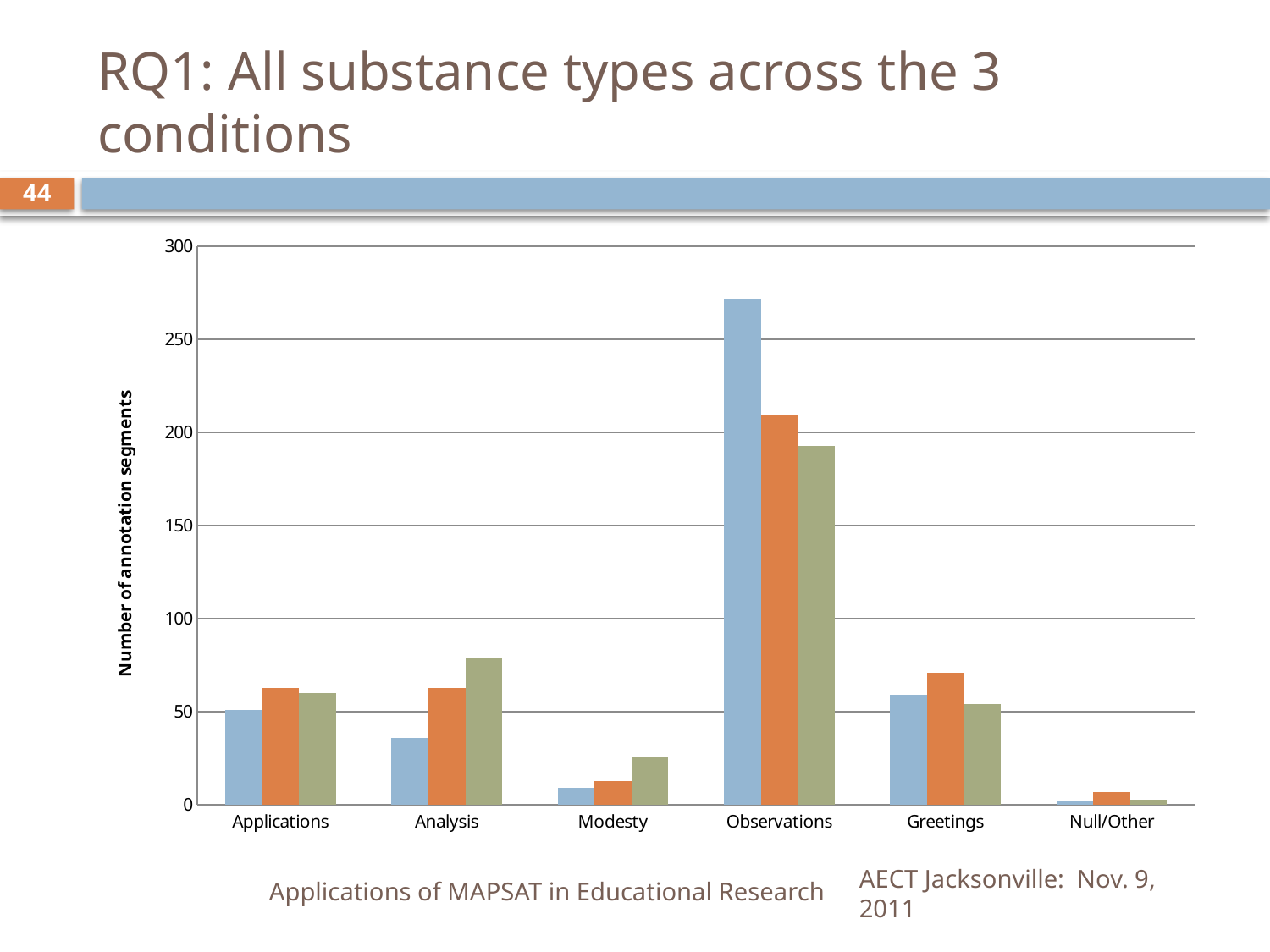
How many bars are plotted for each category in the chart? 3 Is the value of the blue bar for Observations greater or less than 250? greater Is the value of the green bar for Analysis greater or less than 50? greater Is the value of the blue bar for Analysis greater or less than 50? less Which category has the lowest bars in the chart? Null/Other For Observations, which is larger: the blue bar or the orange bar? the blue bar Which category has the highest bars in the chart? Observations What is the title of the y axis of the chart? Number of annotation segments How many categories are shown along the x axis of the chart? 6 What kind of chart is shown on the slide? bar chart For Analysis, which is larger: the blue bar or the green bar? the green bar